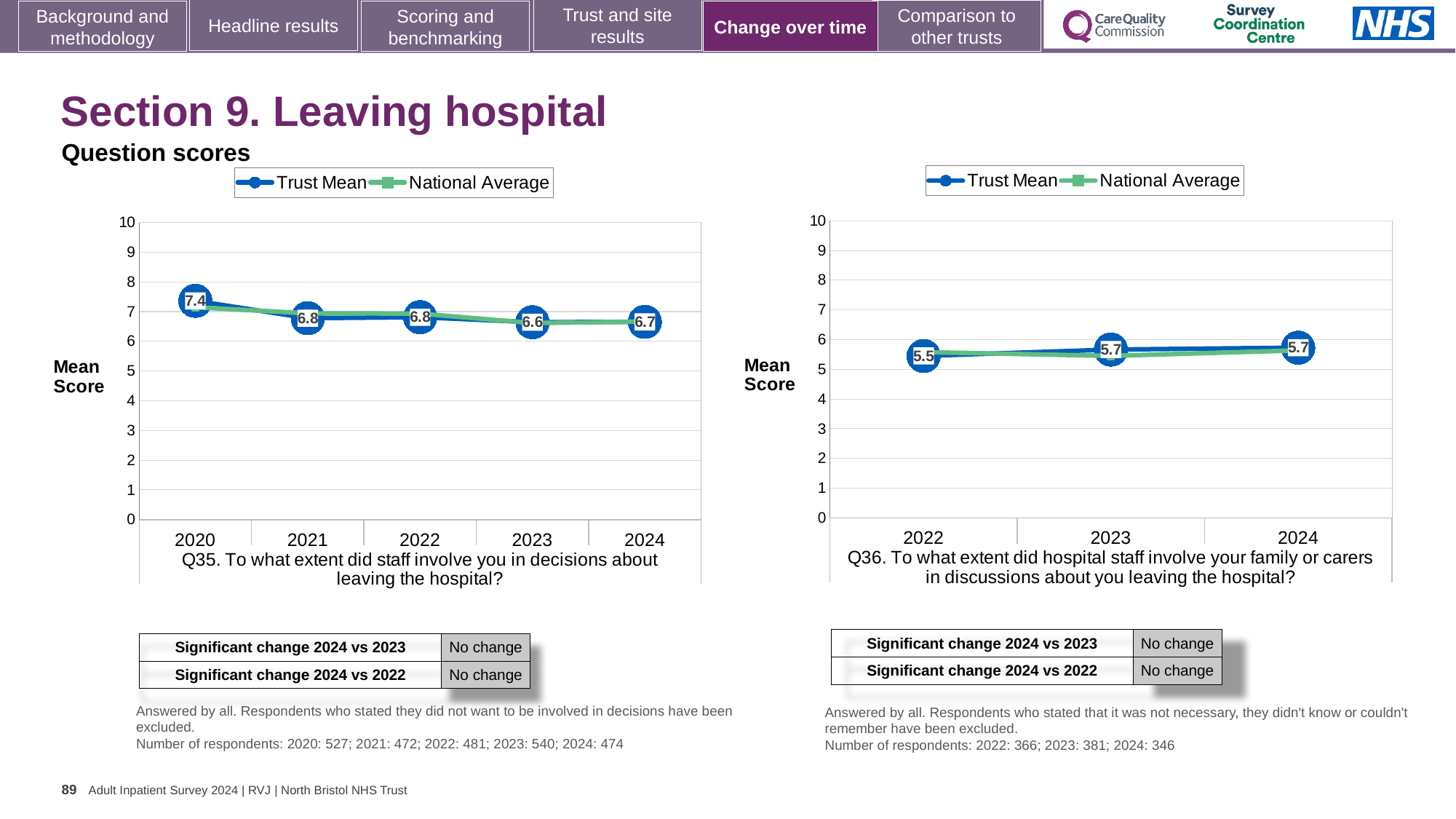
On the Q35 chart (left), what is the Trust Mean for 2024? 6.7 On the Q35 chart (left), which year has the lowest Trust Mean? 2023 On the Q36 chart (right), how many series does the legend list? 2 On the Q35 chart (left), which year has the highest Trust Mean? 2020 What kind of chart is the Q36 chart (right)? line chart On the Q36 chart (right), is the Trust Mean for 2022 larger or smaller than the Trust Mean for 2024? smaller On the Q35 chart (left), how many years are plotted on the x axis? 5 On the Q35 chart (left), does the Trust Mean generally rise or fall from 2020 to 2024? fall On the Q35 chart (left), what is the difference between the Trust Mean in 2020 and in 2024? 0.7 On the Q36 chart (right), what is the Trust Mean for 2022? 5.5 On the Q36 chart (right), what is the Trust Mean for 2024? 5.7 On the Q35 chart (left), what is the Trust Mean for 2020? 7.4